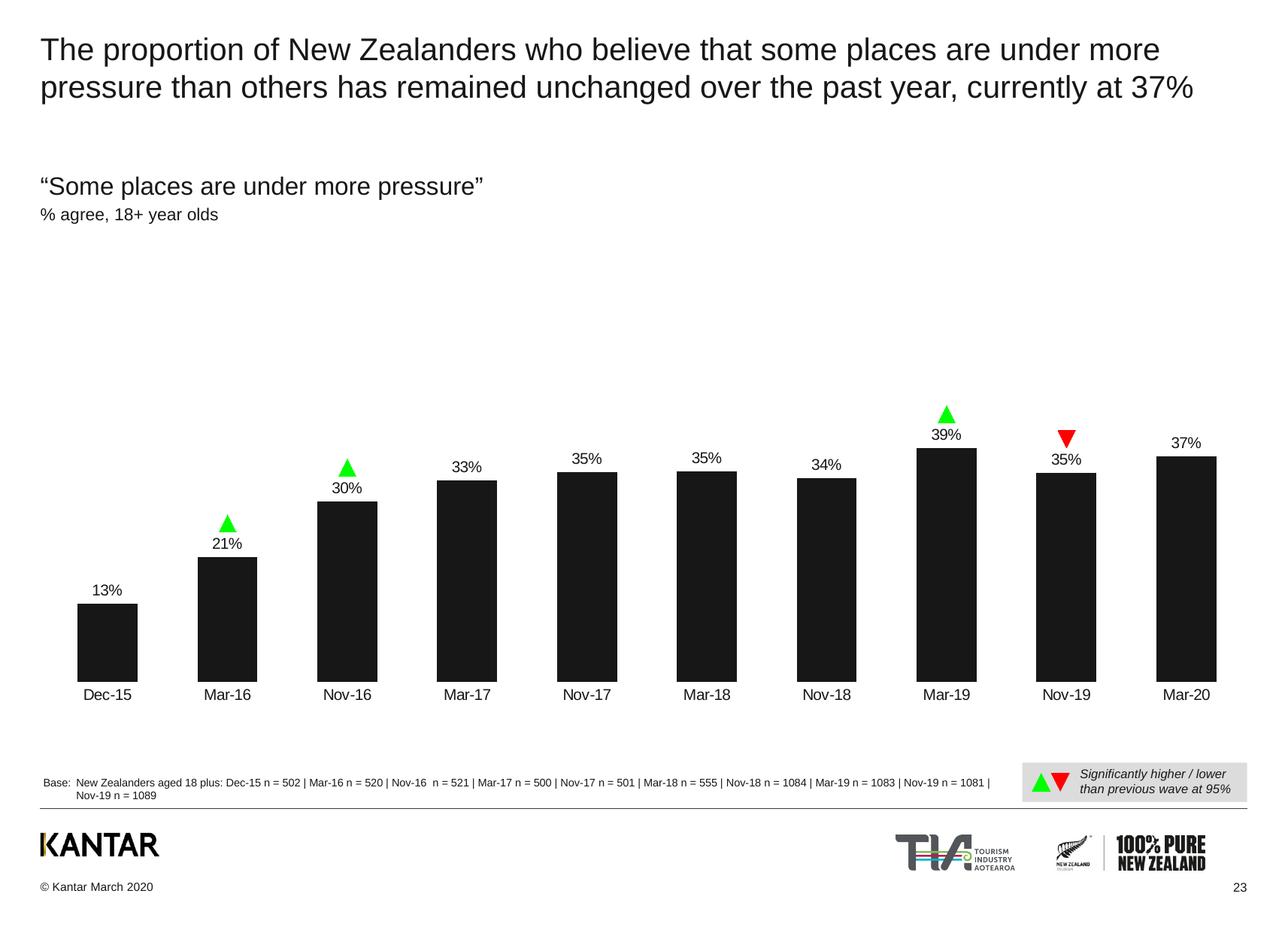
Which is larger, the value for Mar-17 or the value for Nov-18? Nov-18 How many periods are shown on the x axis? 10 What does the red triangle above the Nov-19 bar indicate? Significantly lower than previous wave at 95% What is the value for Mar-20? 37% What is the difference between the values for Mar-16 and Dec-15? 8% What kind of chart is shown on the slide? Bar chart Which period has the highest value? Mar-19 What is the value for Dec-15? 13% What is the difference between the values for Mar-19 and Nov-19? 4% Which period has the lowest value? Dec-15 Do the values generally rise or fall from Dec-15 to Mar-17? Rise What is the value for Nov-16? 30%